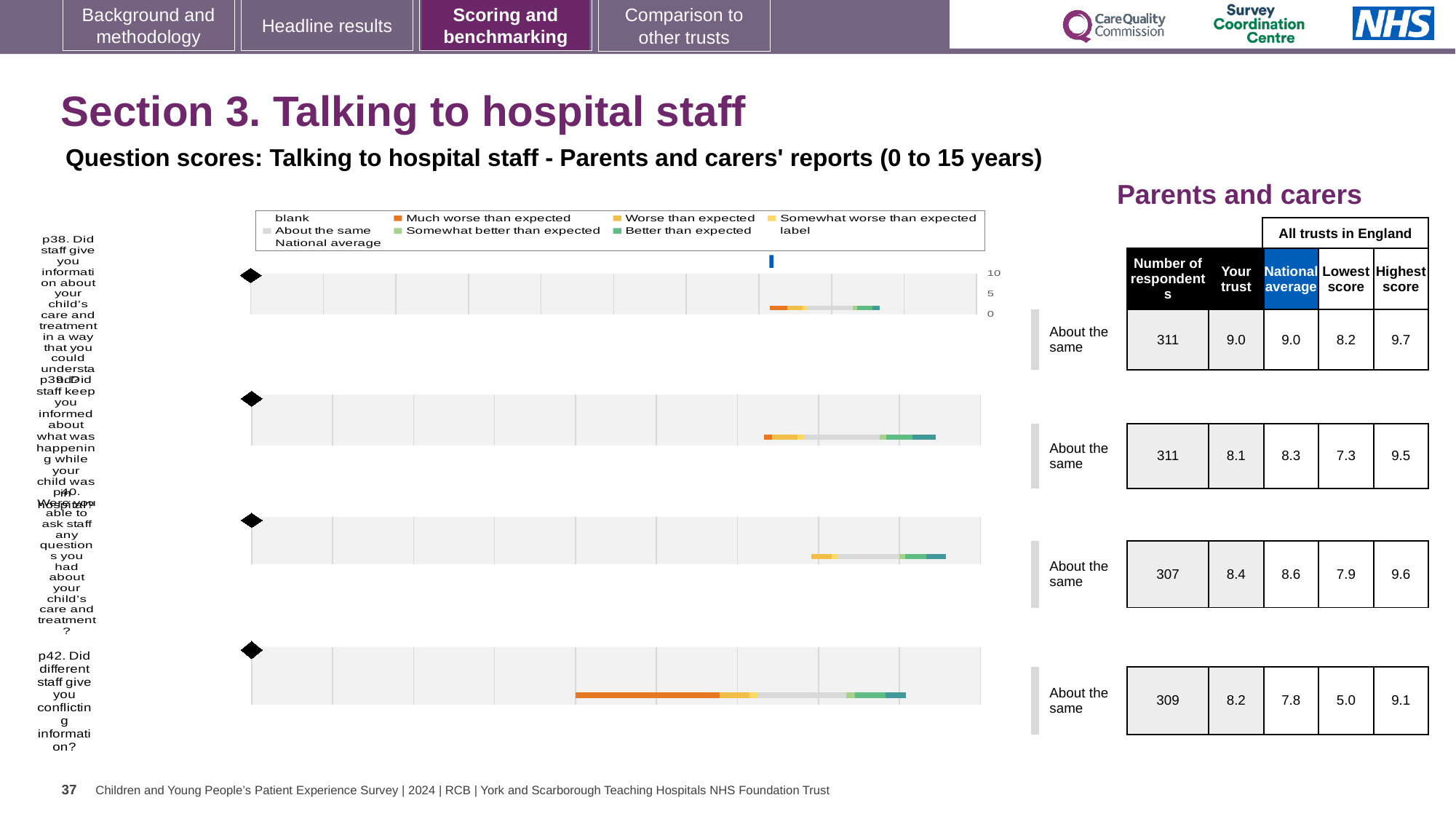
Which question has the highest 'Highest score' across all trusts in England? p38 What benchmark category label is shown next to each of the four questions? About the same Which colour in the legend represents 'Much worse than expected'? Orange How many respondents answered p42? 309 How many survey questions are plotted in the chart? 4 What is the Highest score among all trusts in England for p40 (Were you able to ask staff any questions you had about your child's care and treatment)? 9.6 What is the difference between the 'Your trust' score and the National average for p42? 0.4 What is the Lowest score among all trusts in England for p42 (Did different staff give you conflicting information)? 5.0 What is the National average score for p39 (Did staff keep you informed about what was happening while your child was in hospital)? 8.3 Which question has the lowest 'Lowest score' across all trusts in England? p42 What is the 'Your trust' score for p38 (Did staff give you information about your child's care and treatment in a way that you could understand)? 9.0 Which has the larger 'Your trust' score, p38 or p40? p38